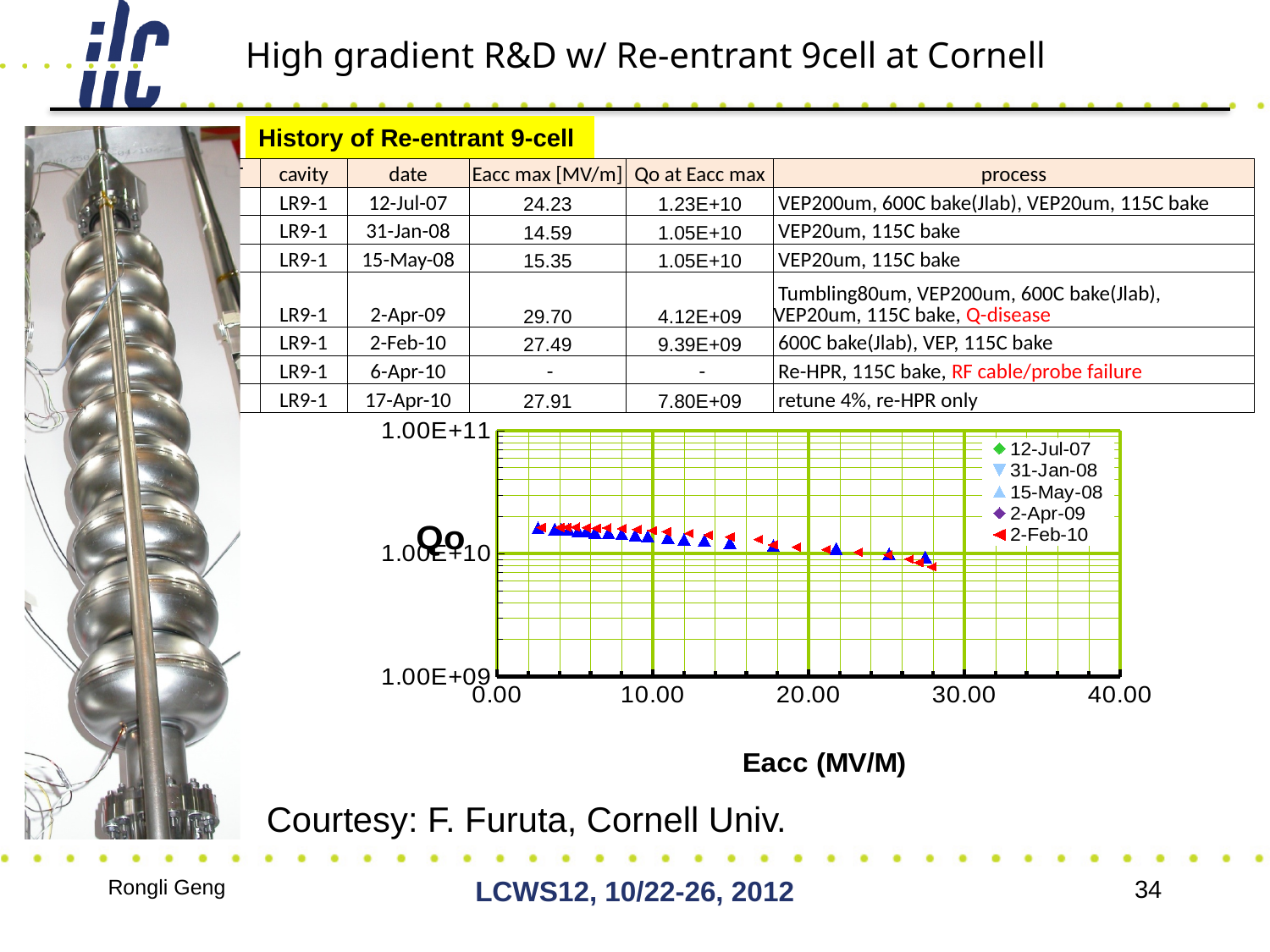
What kind of chart is shown on the slide? scatter chart What is the label of the y axis of the chart? Qo What is the highest value shown on the x axis of the chart? 40.00 Is the Qo value plotted at Eacc = 27.00 greater or less than 1.00E+09? greater As Eacc increases along the x axis, do the plotted Qo values rise or fall? fall How many series does the chart legend list? 5 Is the Qo value plotted at Eacc = 10.00 greater or less than 1.00E+11? less Is the Qo value plotted at Eacc = 5.00 greater or less than 1.00E+10? greater What is the label of the x axis of the chart? Eacc (MV/M)